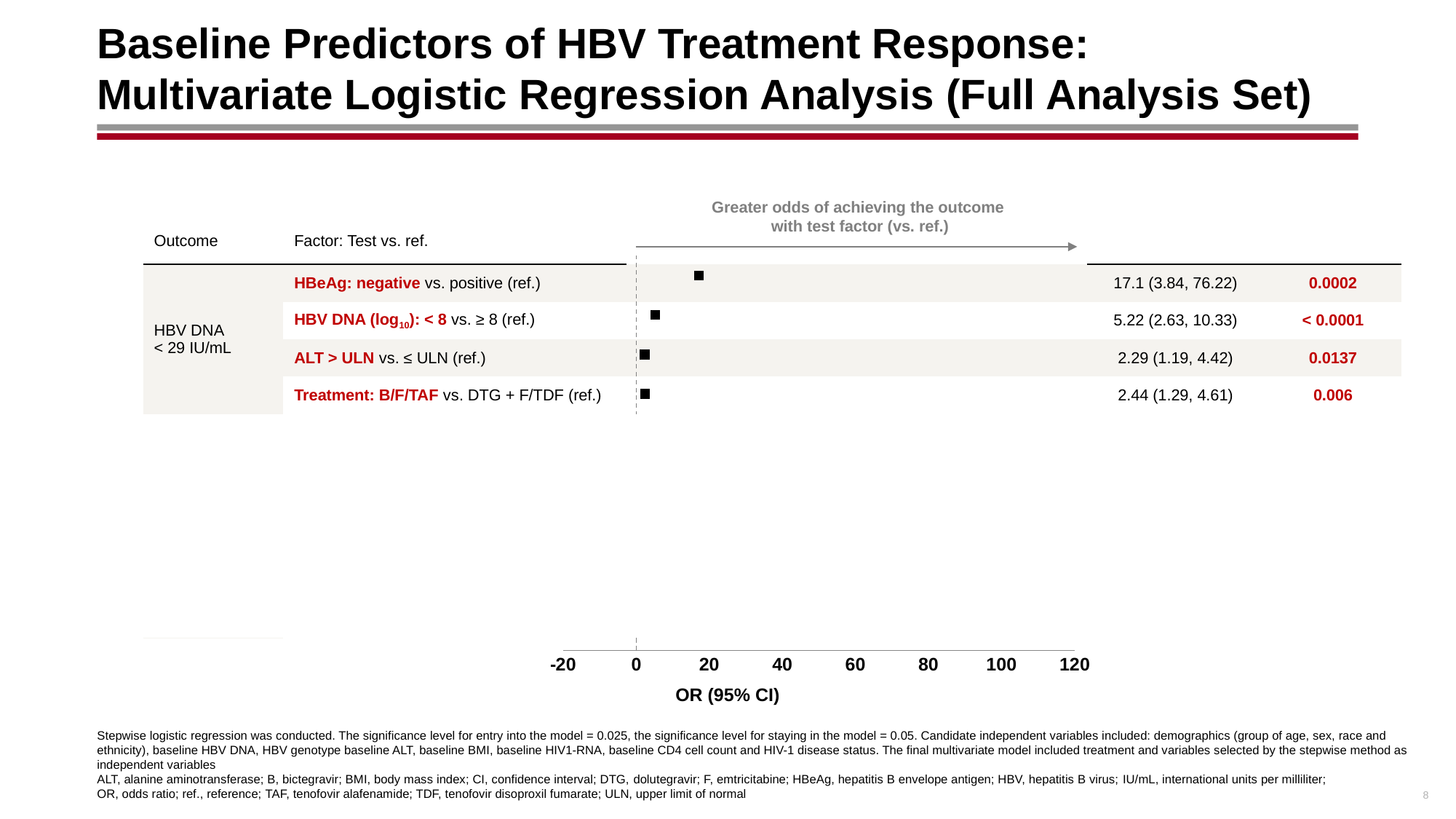
What is the odds ratio (95% CI) for ALT > ULN vs. ≤ ULN (ref.)? 2.29 (1.19, 4.42) How many factors are plotted in the forest plot? 4 What is the p-value shown for ALT > ULN vs. ≤ ULN (ref.)? 0.0137 Which has a larger odds ratio: Treatment: B/F/TAF or ALT > ULN? Treatment: B/F/TAF Which factor has the lowest odds ratio? ALT > ULN vs. ≤ ULN (ref.) What is the odds ratio (95% CI) for Treatment: B/F/TAF vs. DTG + F/TDF (ref.)? 2.44 (1.29, 4.61) What is the odds ratio (95% CI) for HBeAg: negative vs. positive (ref.)? 17.1 (3.84, 76.22) What is the difference between the odds ratio for HBeAg: negative and the odds ratio for HBV DNA (log10): < 8? 11.88 What is the p-value shown for HBV DNA (log10): < 8 vs. ≥ 8 (ref.)? < 0.0001 Which factor has the highest odds ratio? HBeAg: negative vs. positive (ref.) What is the odds ratio (95% CI) for HBV DNA (log10): < 8 vs. ≥ 8 (ref.)? 5.22 (2.63, 10.33) What is the label of the x axis? OR (95% CI)